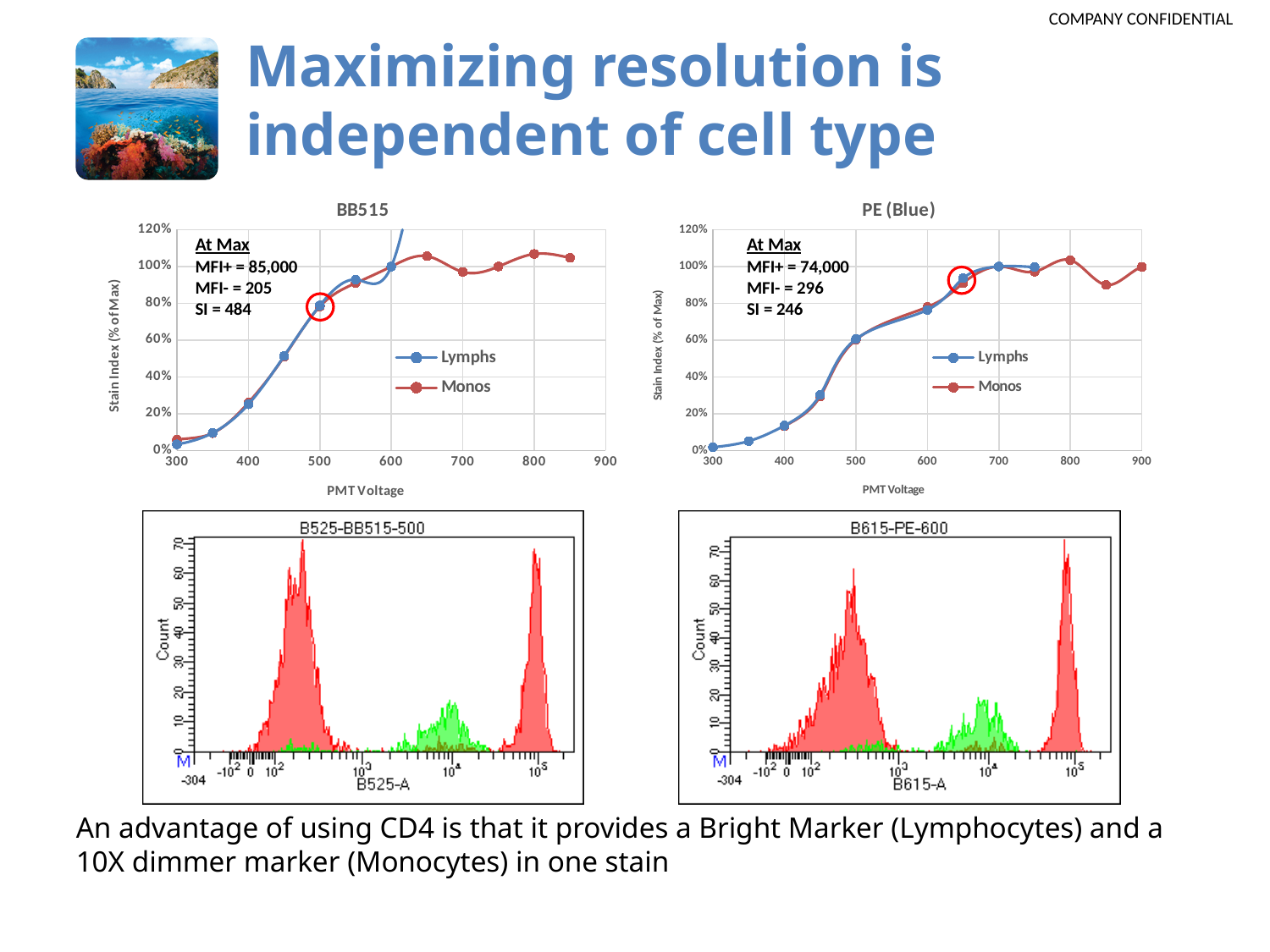
In the PE (Blue) chart, what is the MFI+ value given in the 'At Max' annotation? 74,000 In the PE (Blue) chart, is the Monos value at 450 PMT Voltage greater or less than 40%? less In the PE (Blue) chart, what is the SI value given in the 'At Max' annotation? 246 What is the x-axis title of the PE (Blue) chart? PMT Voltage In the BB515 chart, do the Lymphs values rise or fall as PMT Voltage increases from 300 to 600? rise In the PE (Blue) chart, is the Monos value at 850 PMT Voltage greater or less than 100%? less How many series does the legend of the PE (Blue) chart list? 2 In the BB515 chart, is the Monos value at 400 PMT Voltage greater or less than 40%? less In the BB515 chart, at which PMT Voltage is the Monos series lowest? 300 In the BB515 chart, what is the MFI- value given in the 'At Max' annotation? 205 What kind of chart is the BB515 chart? line chart In the BB515 chart, what is the SI value given in the 'At Max' annotation? 484